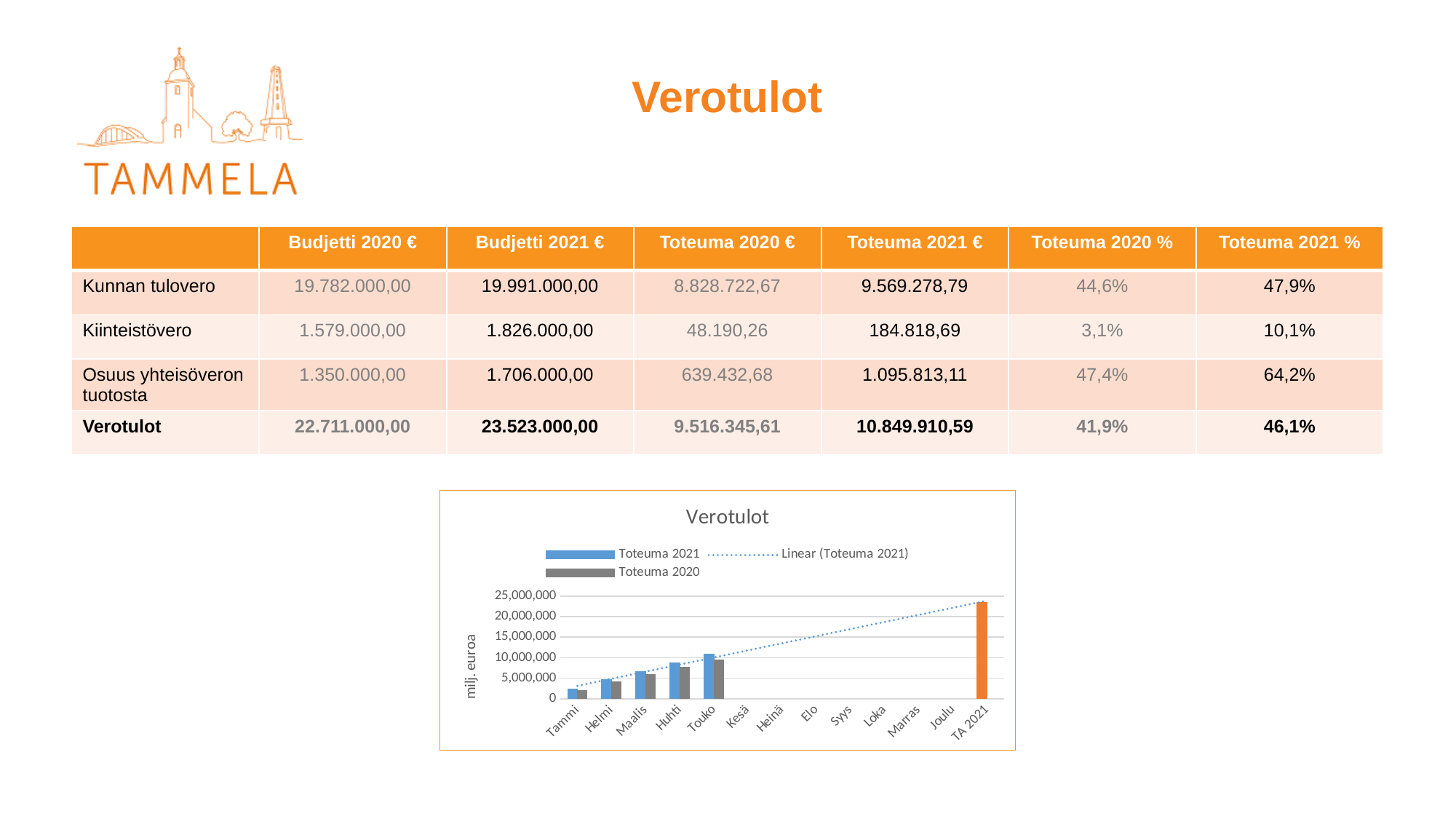
Is the Toteuma 2021 value for Tammi greater or less than 5,000,000? less What kind of chart is shown on the slide? bar chart How many entries does the chart legend list? 3 Do the Toteuma 2021 bars rise or fall from Tammi to Touko? rise Is the Toteuma 2021 value for Maalis greater or less than 5,000,000? greater What is the title of the chart? Verotulot Is the Toteuma 2021 value for Huhti greater or less than 10,000,000? less How many categories are shown on the x axis of the chart? 13 Which category has the tallest bar in the chart? TA 2021 Which month has the lowest Toteuma 2021 bar in the chart? Tammi For Touko, which is larger: Toteuma 2021 or Toteuma 2020? Toteuma 2021